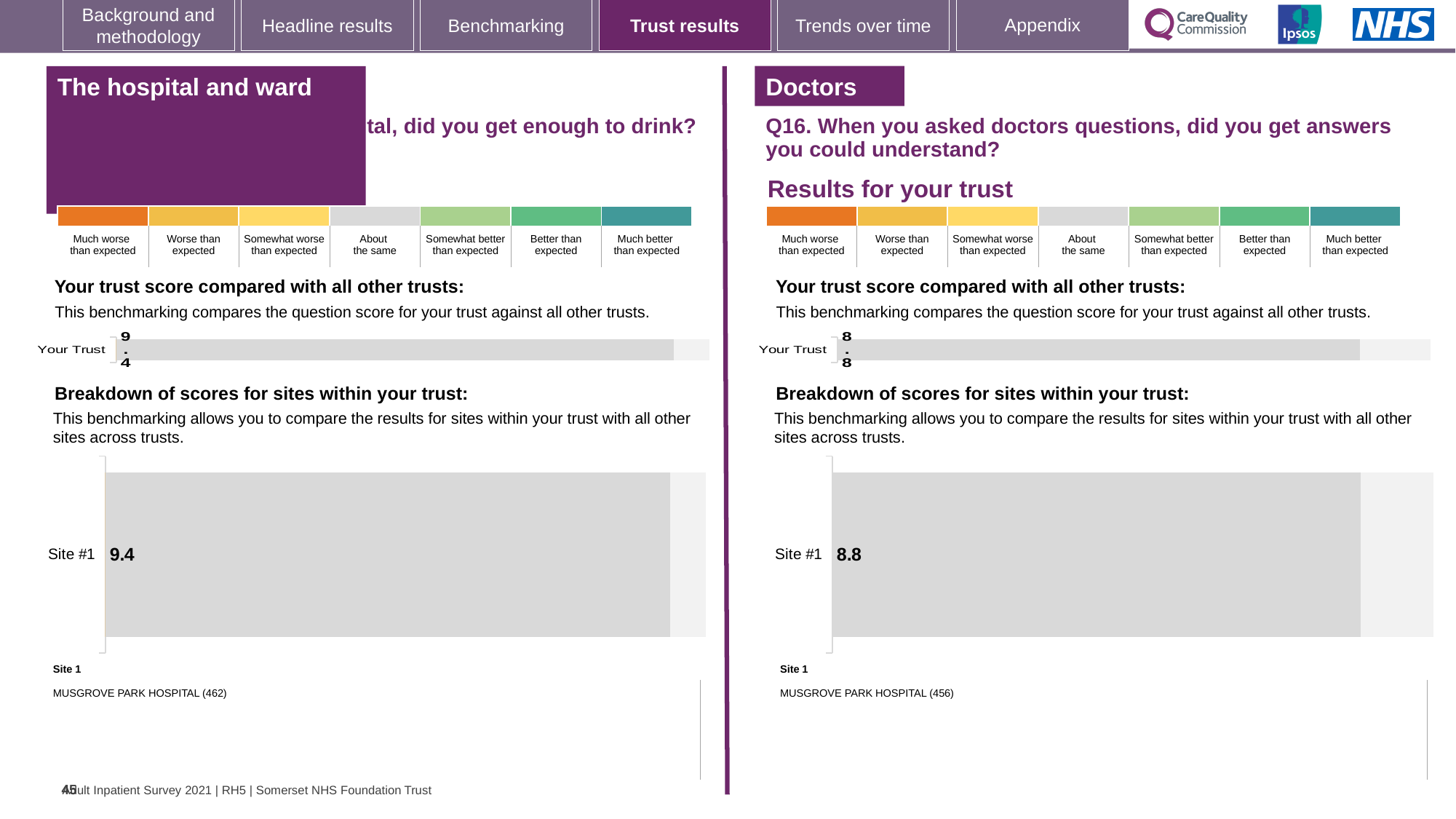
In the right-hand Doctors panel (Q16), what score is shown for Your Trust in the 'Your trust score compared with all other trusts' chart? 8.8 How many sites are shown in the 'Breakdown of scores for sites within your trust' chart in the left-hand panel? 1 In the right-hand Doctors panel (Q16), which site name is listed under Site 1 below the breakdown chart? MUSGROVE PARK HOSPITAL (456) In the left-hand panel, what is the difference between the Your Trust score and the Site #1 score? 0 In the left-hand panel, what score is shown for Your Trust in the 'Your trust score compared with all other trusts' chart? 9.4 In the left-hand panel, what score is shown for Site #1 in the 'Breakdown of scores for sites within your trust' chart? 9.4 Which is larger: the Your Trust score in the left-hand panel or the Your Trust score in the right-hand Doctors panel (Q16)? Left-hand panel (9.4) Is the Your Trust score in the right-hand Doctors panel (Q16) greater or less than 9? less What is the difference between the Site #1 score in the left-hand panel and the Site #1 score in the right-hand Doctors panel (Q16)? 0.6 In the right-hand Doctors panel (Q16), what score is shown for Site #1 in the 'Breakdown of scores for sites within your trust' chart? 8.8 What kind of chart is used to show the Site #1 score in the right-hand Doctors panel (Q16)? Bar chart In the left-hand panel, what number of respondents is shown in brackets after MUSGROVE PARK HOSPITAL under Site 1? 462